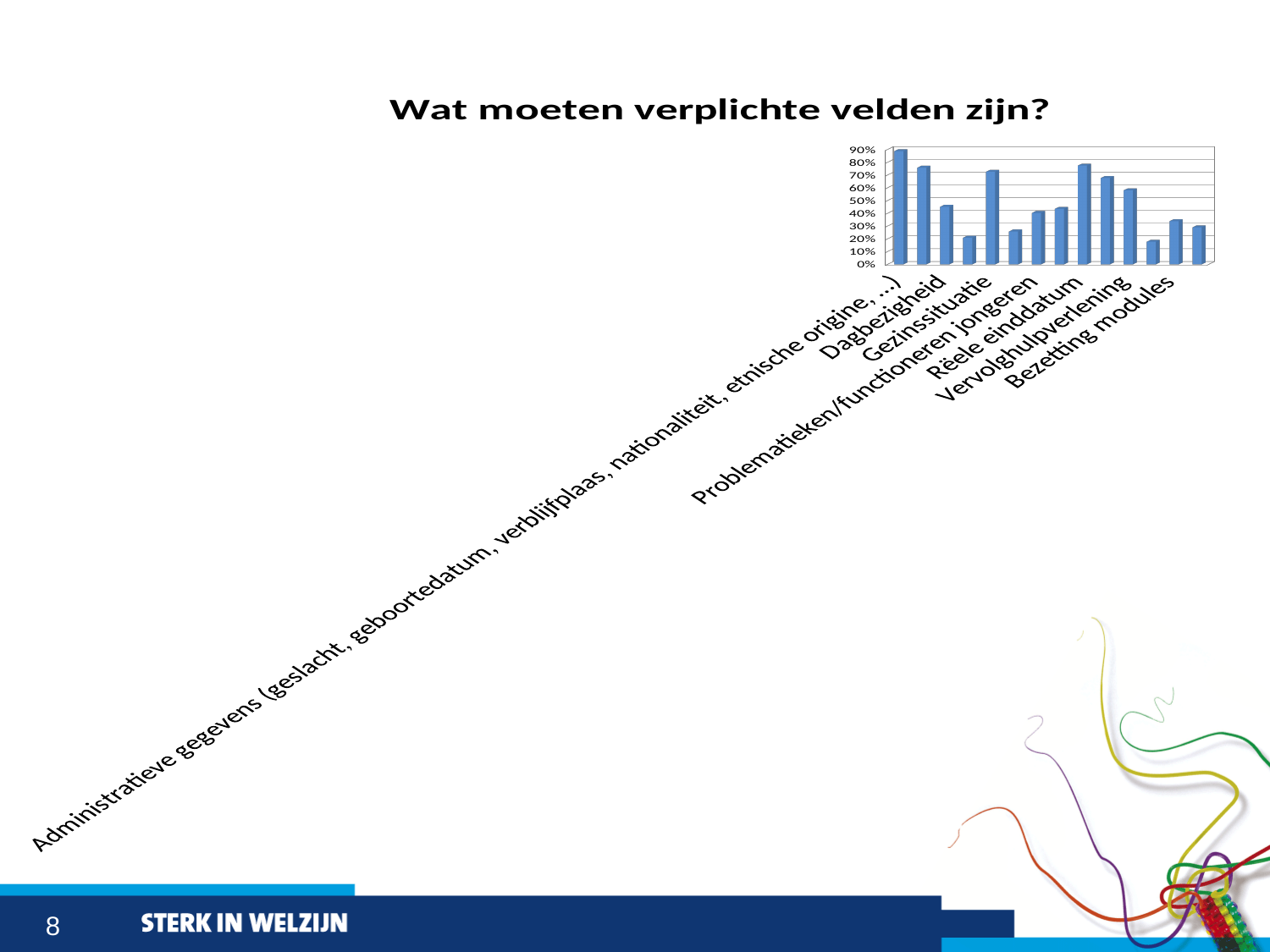
Is the value for Bezetting modules greater or less than 50%? less What is the highest tick label shown on the vertical axis? 90% Which is larger, the value for Gezinssituatie or the value for Dagbezigheid? Gezinssituatie How many bars are plotted in the chart? 14 Is the value for Dagbezigheid greater or less than 60%? less Which labelled category has the highest bar in the chart? Administratieve gegevens (geslacht, geboortedatum, verblijfplaas, nationaliteit, etnische origine, ...) Is the value for Problematieken/functioneren jongeren greater or less than 60%? less What kind of chart is shown on the slide? bar chart What is the title of the chart? Wat moeten verplichte velden zijn?